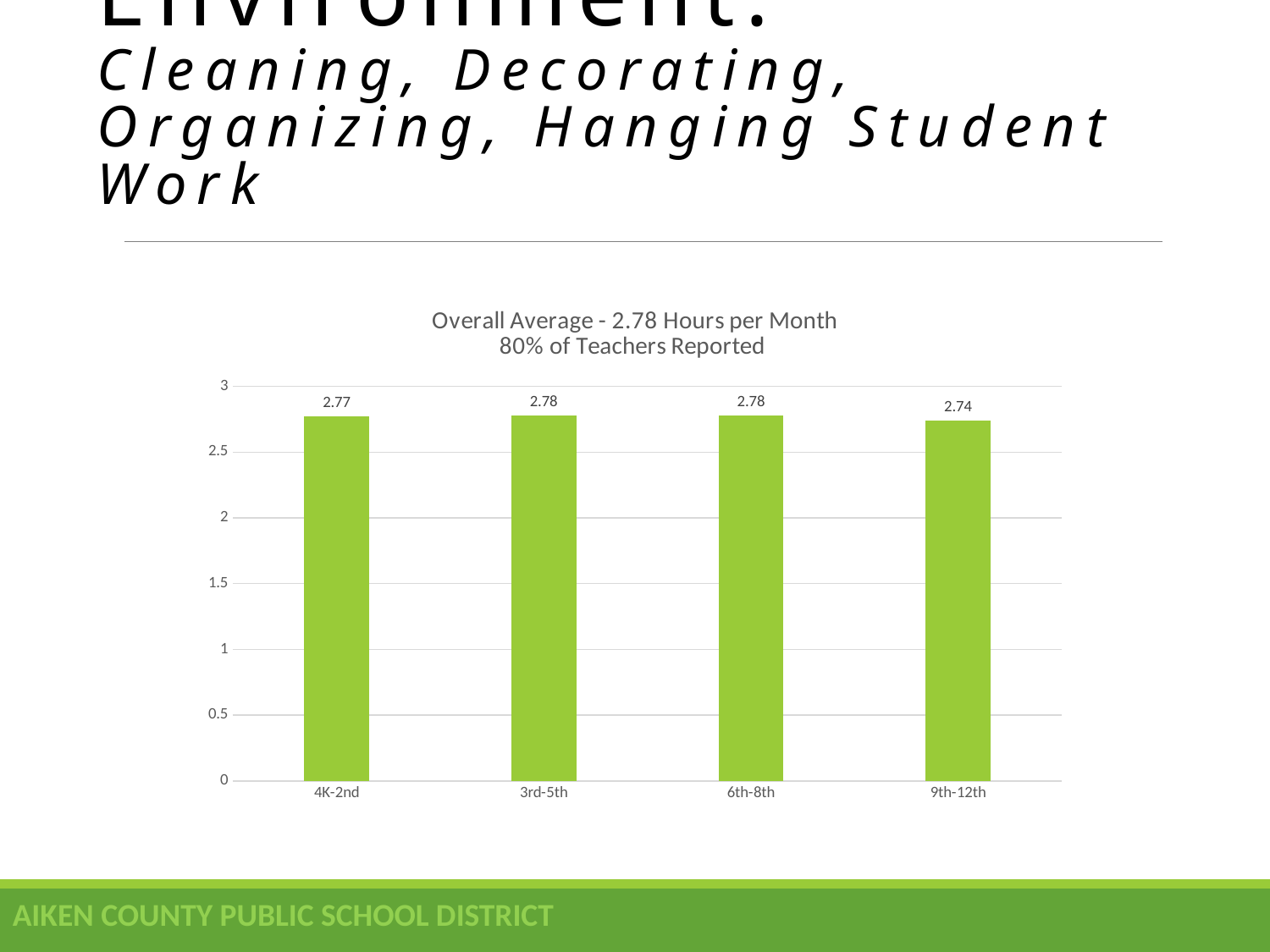
Which is larger, the value for 4K-2nd or the value for 9th-12th? 4K-2nd What is the value for 4K-2nd? 2.77 How many grade bands are shown on the x axis? 4 What is the value for 9th-12th? 2.74 What is the value for 6th-8th? 2.78 According to the chart title, what is the overall average in hours per month? 2.78 Which grade band has the lowest value? 9th-12th What kind of chart is shown on the slide? bar chart What is the difference between the values for 6th-8th and 9th-12th? 0.04 Is the value for 9th-12th greater or less than 2.5? greater What is the difference between the values for 4K-2nd and 9th-12th? 0.03 What is the value for 3rd-5th? 2.78